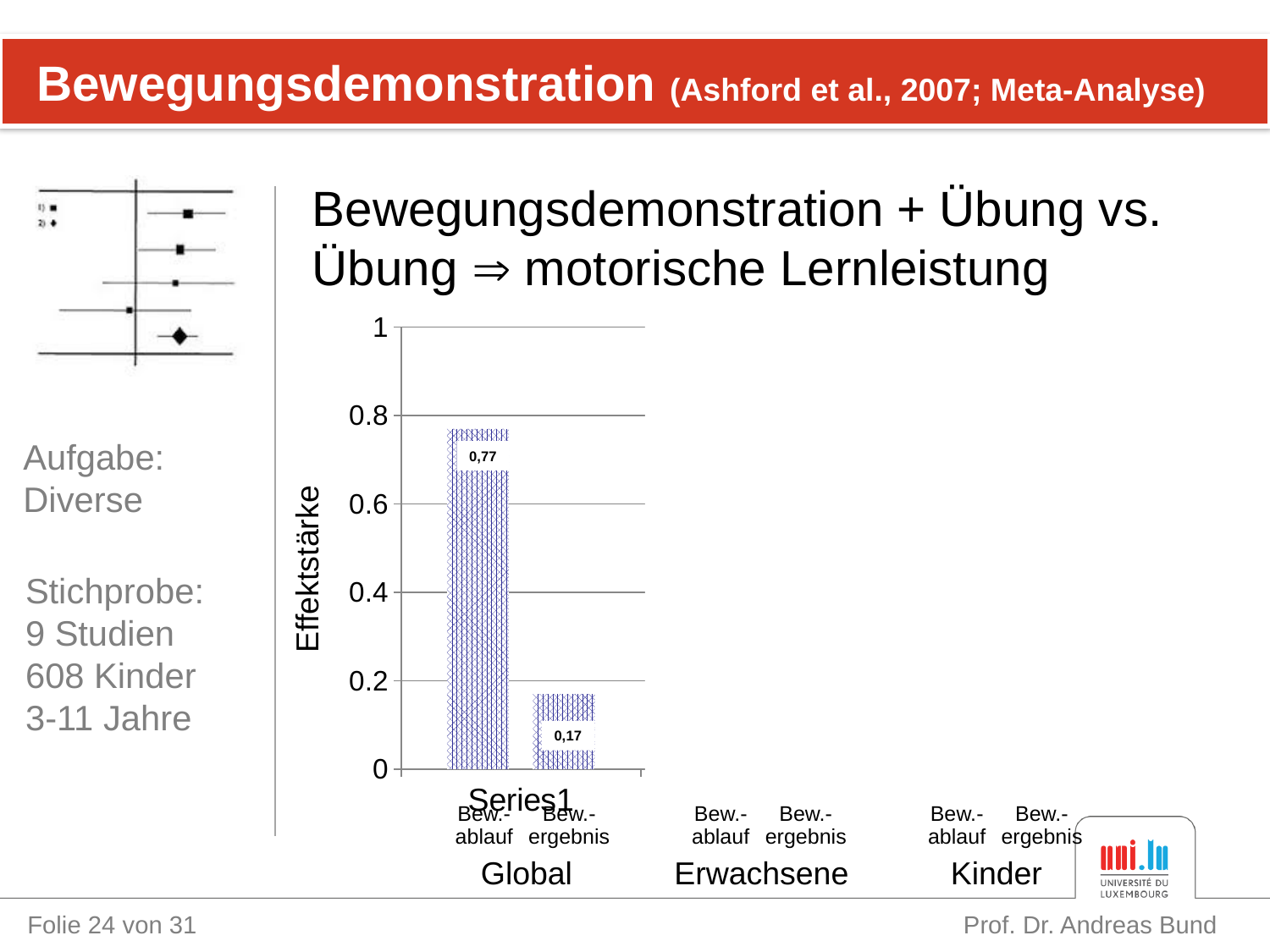
How many bars are plotted in the chart? 2 What is the value of the Bew.-ablauf bar in the Global group? 0,77 What is the label of the vertical axis of the chart? Effektstärke What is the value of the Bew.-ergebnis bar in the Global group? 0,17 Do the bar values rise or fall from Bew.-ablauf to Bew.-ergebnis? fall Which of the two plotted bars is higher, Bew.-ablauf or Bew.-ergebnis? Bew.-ablauf Is the value for Bew.-ablauf greater or less than 0.6? greater Which of the two plotted bars is lower, Bew.-ablauf or Bew.-ergebnis? Bew.-ergebnis What kind of chart is shown on the slide? bar chart Is the value for Bew.-ergebnis greater or less than 0.2? less What is the maximum value shown on the vertical axis of the chart? 1 What is the difference between the Bew.-ablauf value (0,77) and the Bew.-ergebnis value (0,17)? 0,60